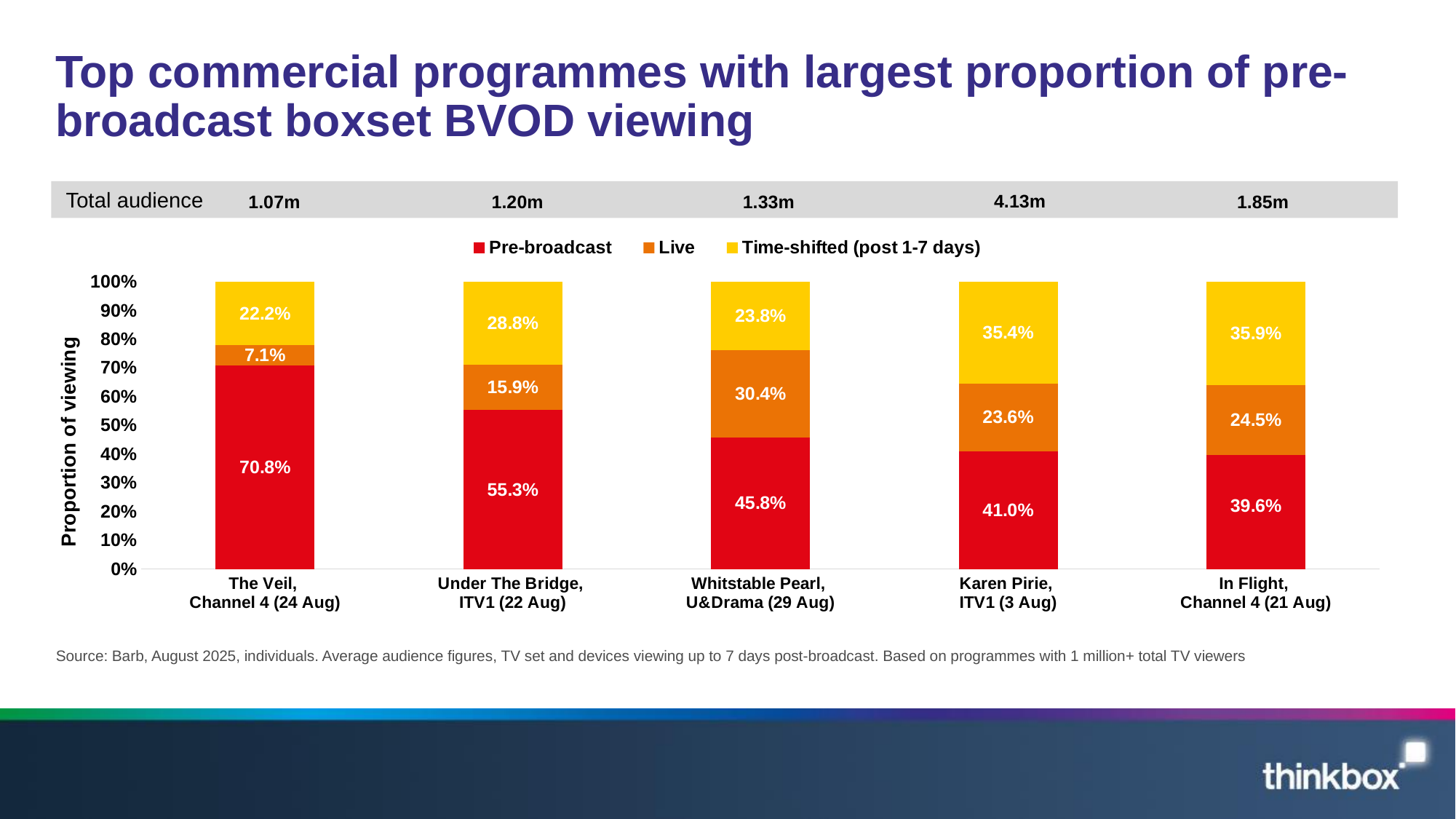
Which is larger: the Live share for Whitstable Pearl, U&Drama (29 Aug) or the Live share for In Flight, Channel 4 (21 Aug)? Whitstable Pearl, U&Drama (29 Aug) Which programme has the lowest Live share? The Veil, Channel 4 (24 Aug) What is the Live share for Karen Pirie, ITV1 (3 Aug)? 23.6% How many series does the legend list? 3 What is the difference between the Pre-broadcast shares of Under The Bridge, ITV1 (22 Aug) and Whitstable Pearl, U&Drama (29 Aug)? 9.5% What is the total audience shown for Karen Pirie, ITV1 (3 Aug)? 4.13m How many programmes are shown on the x axis? 5 Which programme has the highest Pre-broadcast share? The Veil, Channel 4 (24 Aug) What is the Pre-broadcast share for The Veil, Channel 4 (24 Aug)? 70.8% What kind of chart is shown on the slide? Stacked bar chart What is the Time-shifted (post 1-7 days) share for Under The Bridge, ITV1 (22 Aug)? 28.8% Does the Pre-broadcast share rise or fall moving left to right across the programmes? Fall